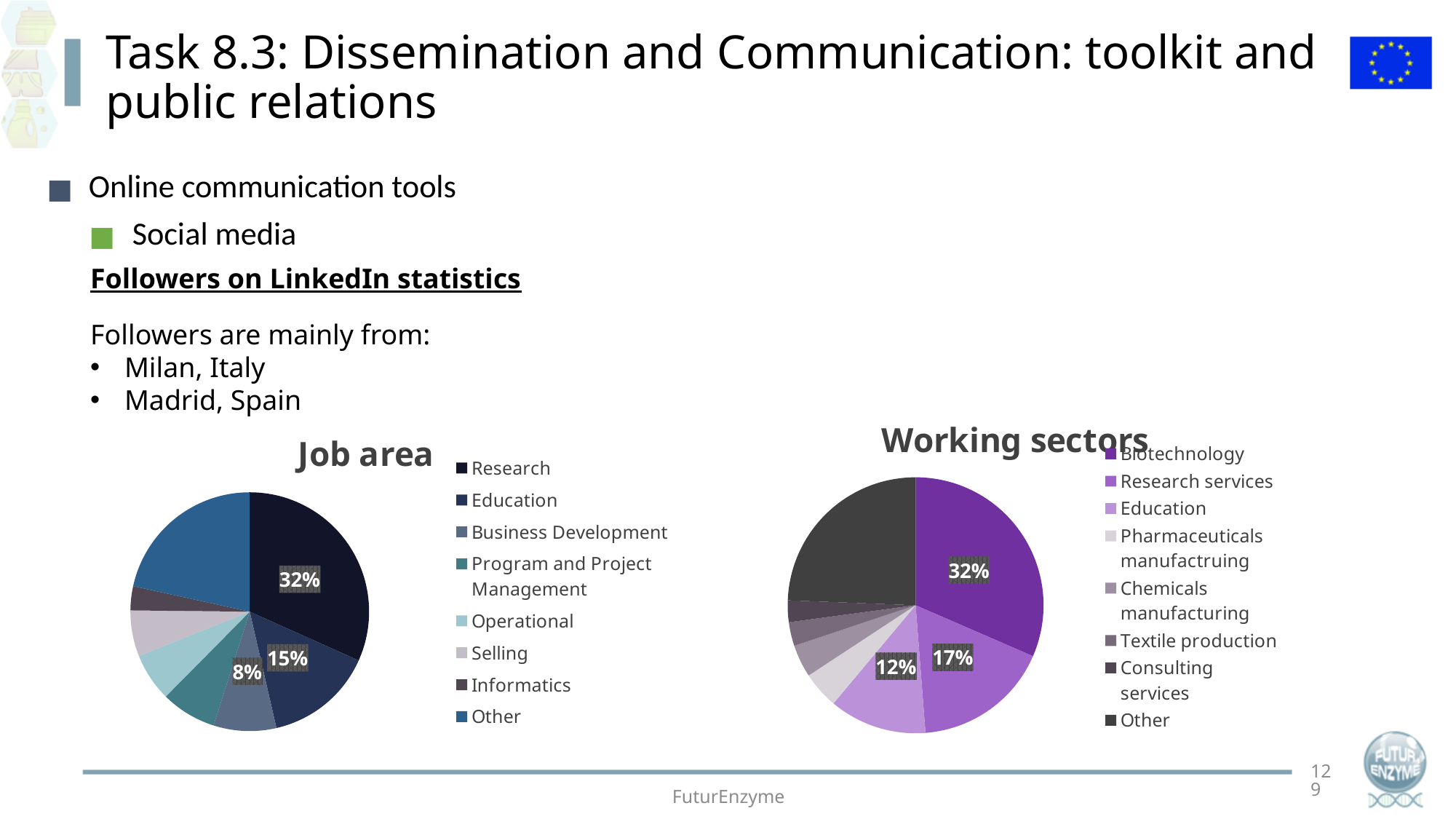
In the Job area chart, how many percentage points larger is Research than Education? 17 In the Job area chart, which job area has the largest share? Research In the Working sectors chart, how many percentage points larger is Research services than Education? 5 In the Working sectors chart, which is larger, Biotechnology or Research services? Biotechnology How many categories does the legend of the Working sectors chart list? 8 In the Job area chart, what share of followers are in Education? 15% In the Working sectors chart, what share of followers work in Education? 12% What type of chart is the Job area chart? Pie chart In the Working sectors chart, what share of followers work in Research services? 17% In the Working sectors chart, what share of followers work in Biotechnology? 32% In the Job area chart, what share of followers are in Business Development? 8% In the Job area chart, what share of followers are in Research? 32%